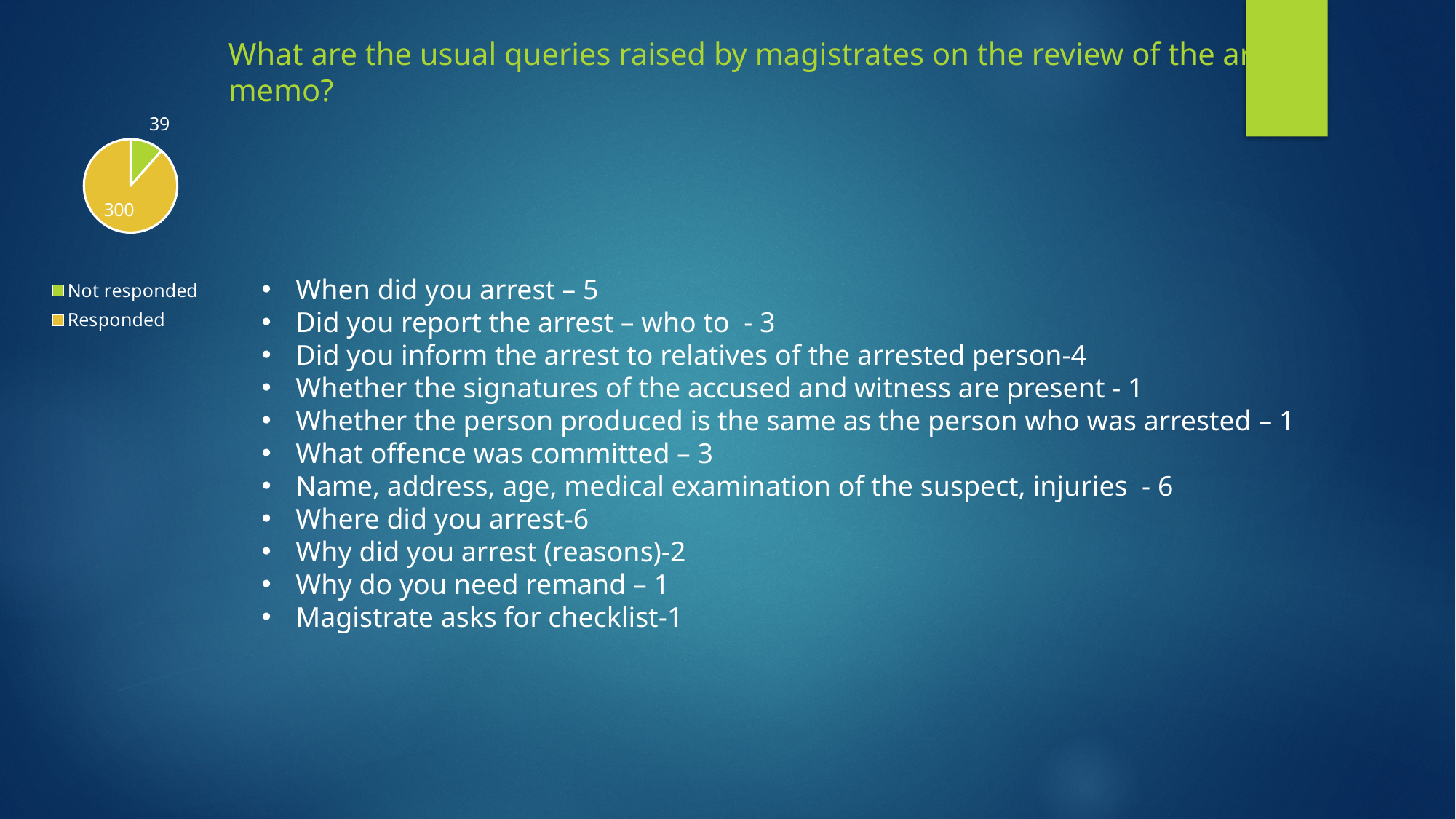
What is the value for Responded in the pie chart? 300 What is the value for Not responded in the pie chart? 39 How many slices does the pie chart have? 2 Which is larger in the pie chart, Responded or Not responded? Responded Which category has the largest slice in the pie chart? Responded Which category has the smallest slice in the pie chart? Not responded What is the difference between the Responded and Not responded values in the pie chart? 261 What is the total of the two values shown in the pie chart? 339 How many entries does the pie chart's legend list? 2 What kind of chart is shown on the slide? pie chart To the nearest whole percent, what share of the pie does Responded represent? 88% What colour is the Not responded slice in the pie chart? green